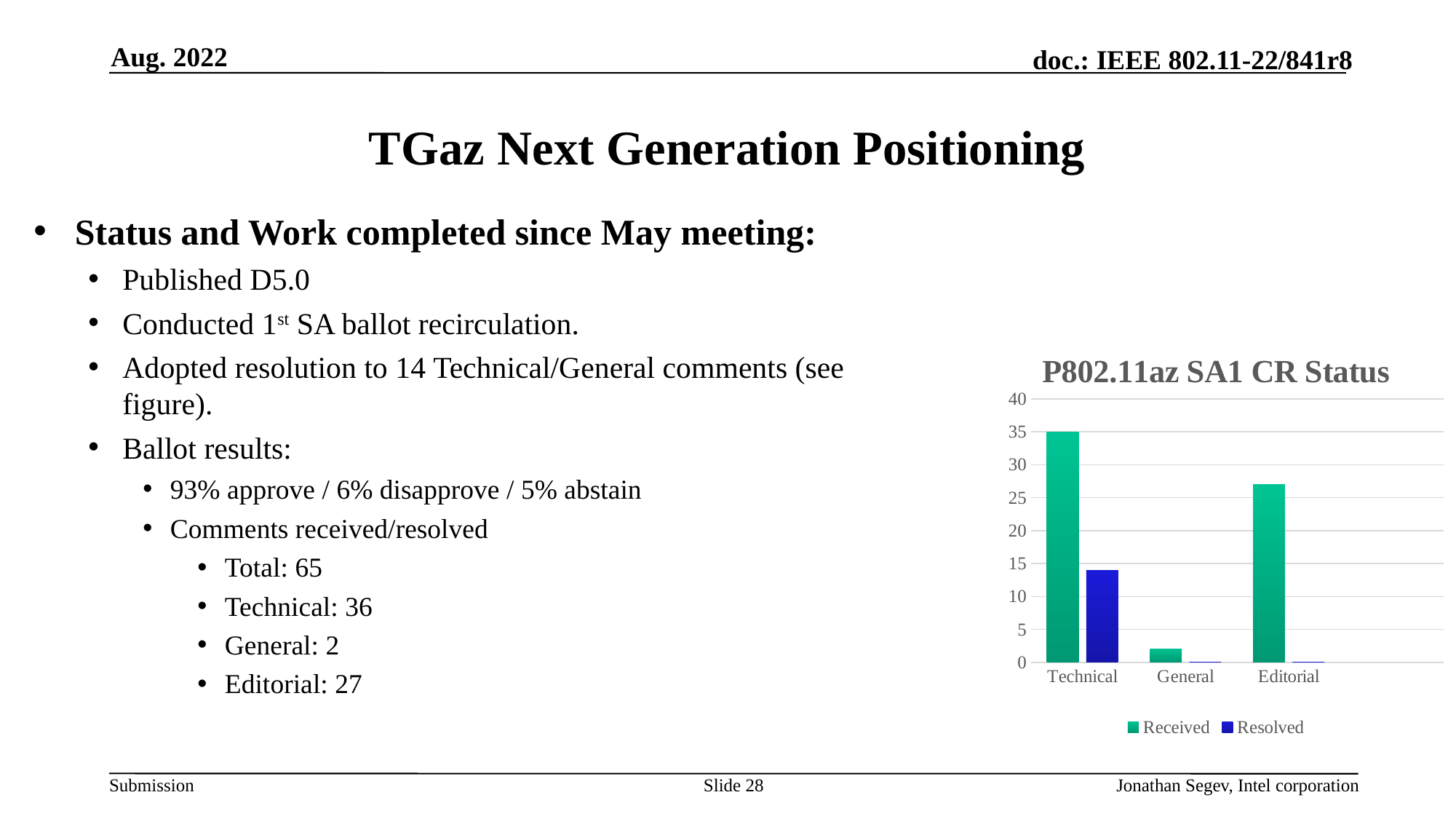
Is the Received value for General greater or less than 5? less What is the title of the chart on the slide? P802.11az SA1 CR Status Which is larger in the "P802.11az SA1 CR Status" chart: the Received value for Technical or the Received value for Editorial? Technical Which category has the highest Received value in the "P802.11az SA1 CR Status" chart? Technical Which category has the highest Resolved value in the "P802.11az SA1 CR Status" chart? Technical Which category has the lowest Received value in the "P802.11az SA1 CR Status" chart? General Is the Resolved value for Technical greater or less than 20? less How many series does the legend of the "P802.11az SA1 CR Status" chart list? 2 Is the Received value for Technical greater or less than 30? greater How many categories are shown on the x axis of the "P802.11az SA1 CR Status" chart? 3 What kind of chart is shown under the title "P802.11az SA1 CR Status"? bar chart